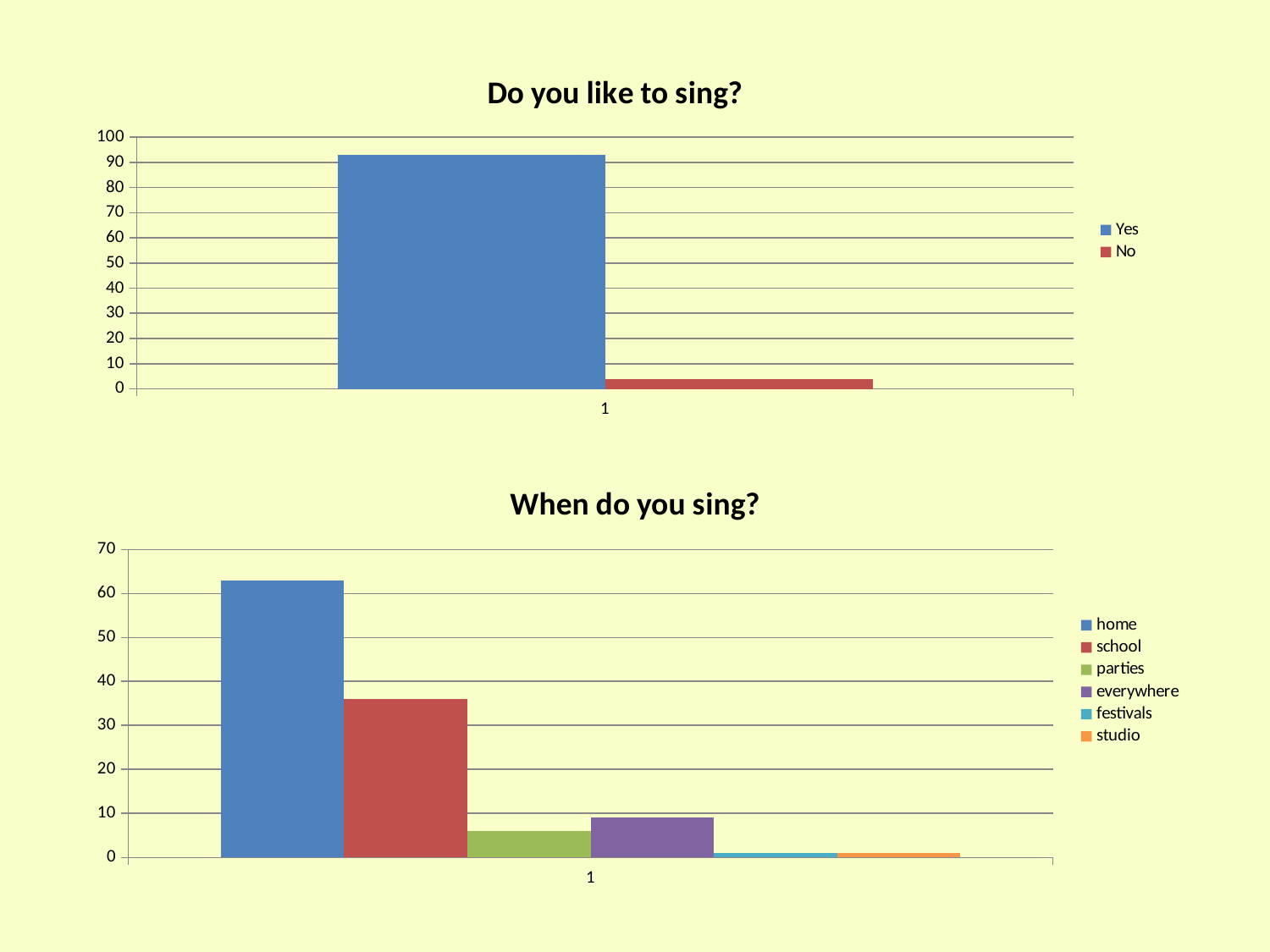
What kind of chart is the 'Do you like to sing?' chart? bar chart In the 'Do you like to sing?' chart, which series has the highest value? Yes In the 'When do you sing?' chart, which series has the highest value? home In the 'Do you like to sing?' chart, is the value for No greater or less than 10? less How many series does the legend of the 'When do you sing?' chart list? 6 How many series does the legend of the 'Do you like to sing?' chart list? 2 In the 'When do you sing?' chart, which is larger, the value for parties or the value for everywhere? everywhere In the 'When do you sing?' chart, is the value for home greater or less than 60? greater In the 'When do you sing?' chart, is the value for school greater or less than 40? less What is the title of the bottom chart on the slide? When do you sing? In the 'When do you sing?' chart, what colour is the bar for school? red